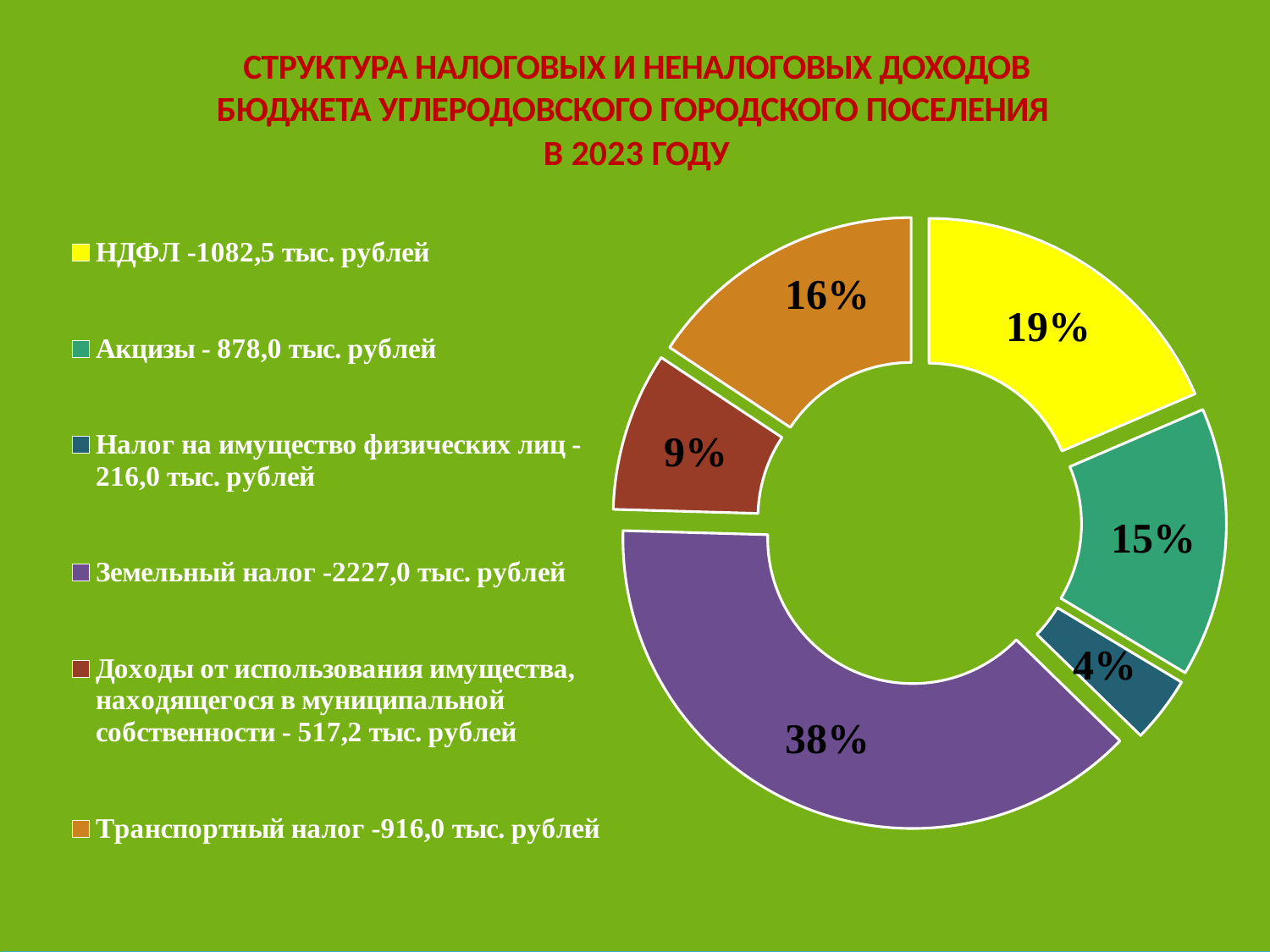
Which slice is larger, Акцизы or Транспортный налог? Транспортный налог What share of the pie does Транспортный налог account for? 16% What kind of chart is shown on the slide? doughnut (pie) chart Which category has the smallest slice of the pie? Налог на имущество физических лиц What share of the pie does НДФЛ account for? 19% What is the difference in percentage points between the Земельный налог slice and the Акцизы slice? 23 percentage points What colour is the slice for Земельный налог? purple What share of the pie does Налог на имущество физических лиц account for? 4% According to the legend, what is the amount for Акцизы? 878,0 тыс. рублей Which category has the largest slice of the pie? Земельный налог How many categories are shown in the chart? 6